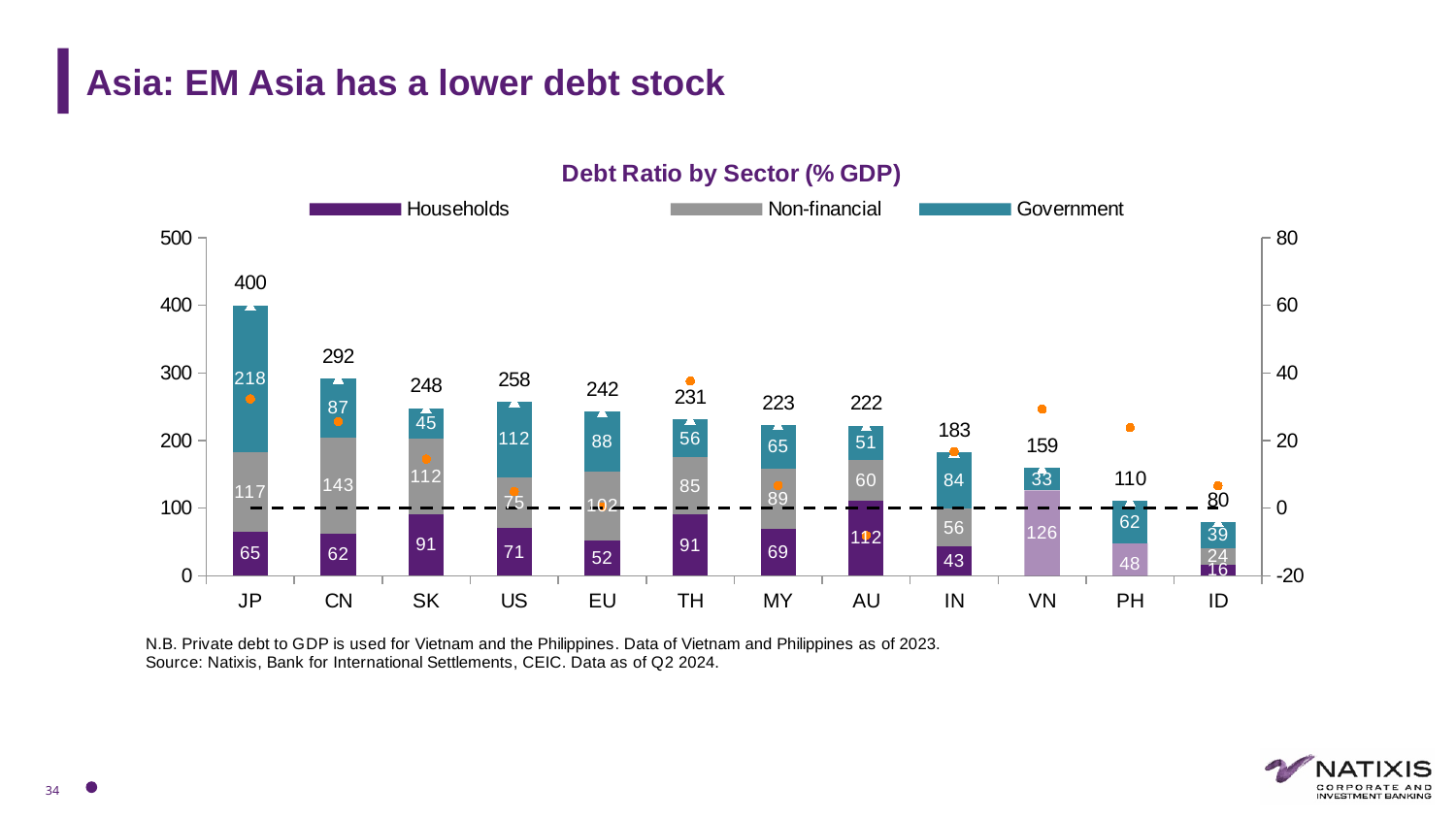
What is the title of the chart? Debt Ratio by Sector (% GDP) What is the total debt ratio shown for JP? 400 What is the difference between the total debt ratios of CN and SK? 44 How many countries or regions are shown on the x axis? 12 How many series does the legend list? 3 What is the total of the stacked bar for IN? 183 Which has a larger Non-financial value, CN or JP? CN What is the Government debt ratio value for US? 112 What is the Households value for AU? 112 Which country has the lowest total debt ratio? ID What kind of chart is this? Stacked bar chart Which country has the highest total debt ratio? JP